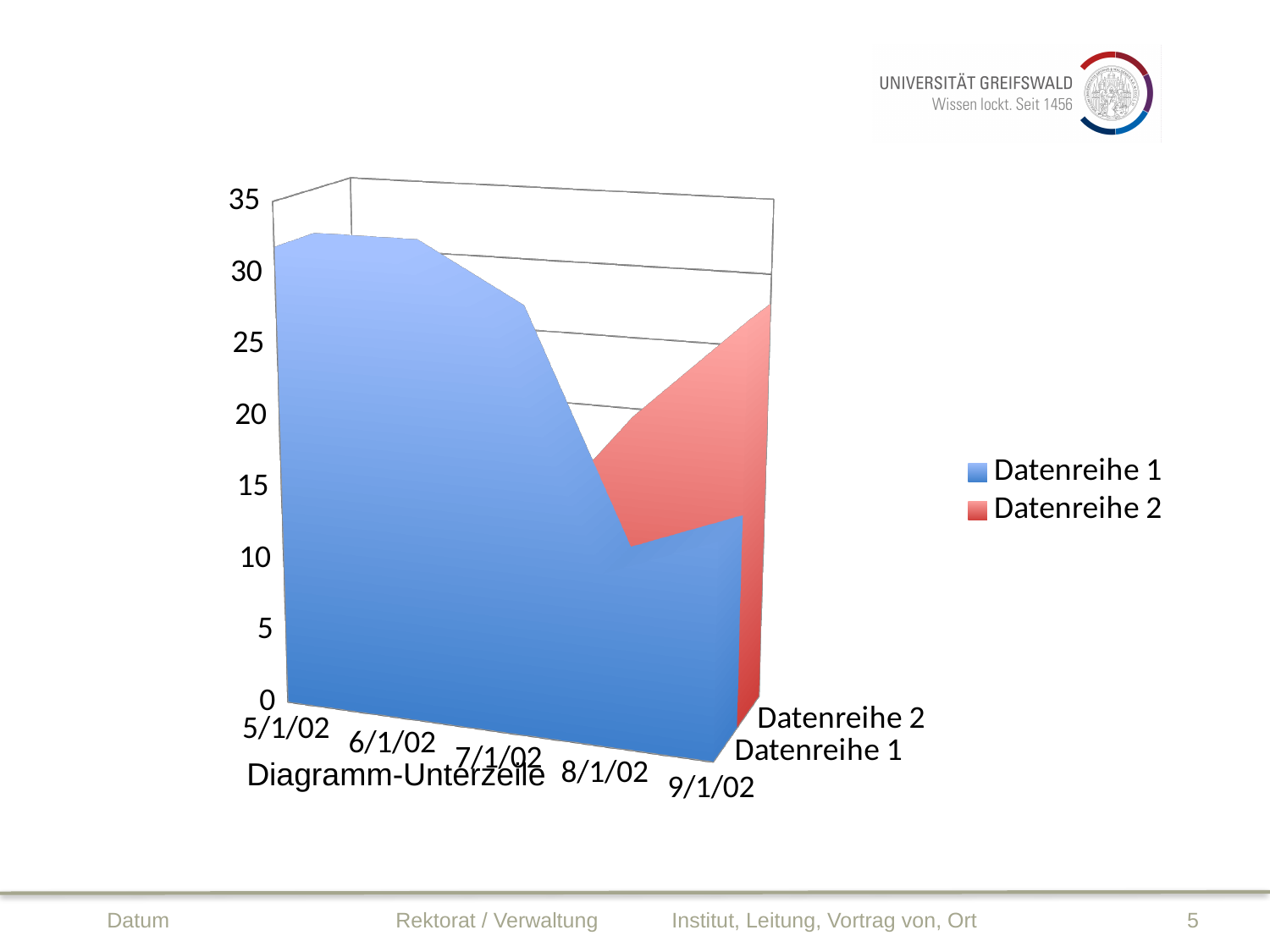
What is the highest value shown on the vertical axis of the chart? 35 Is the value for Datenreihe 2 at 9/1/02 greater or less than 20? greater What is the first date shown on the x axis? 5/1/02 Is the value for Datenreihe 1 at 8/1/02 greater or less than 20? less How many series does the legend list? 2 Is the value for Datenreihe 1 at 7/1/02 greater or less than 25? greater Which is larger for Datenreihe 1: the value at 5/1/02 or the value at 8/1/02? 5/1/02 Does the value for Datenreihe 1 rise or fall from 5/1/02 to 8/1/02? fall How many dates are shown on the x axis of the chart? 5 What kind of chart is shown on the slide? area chart Which series is shown in blue in the chart? Datenreihe 1